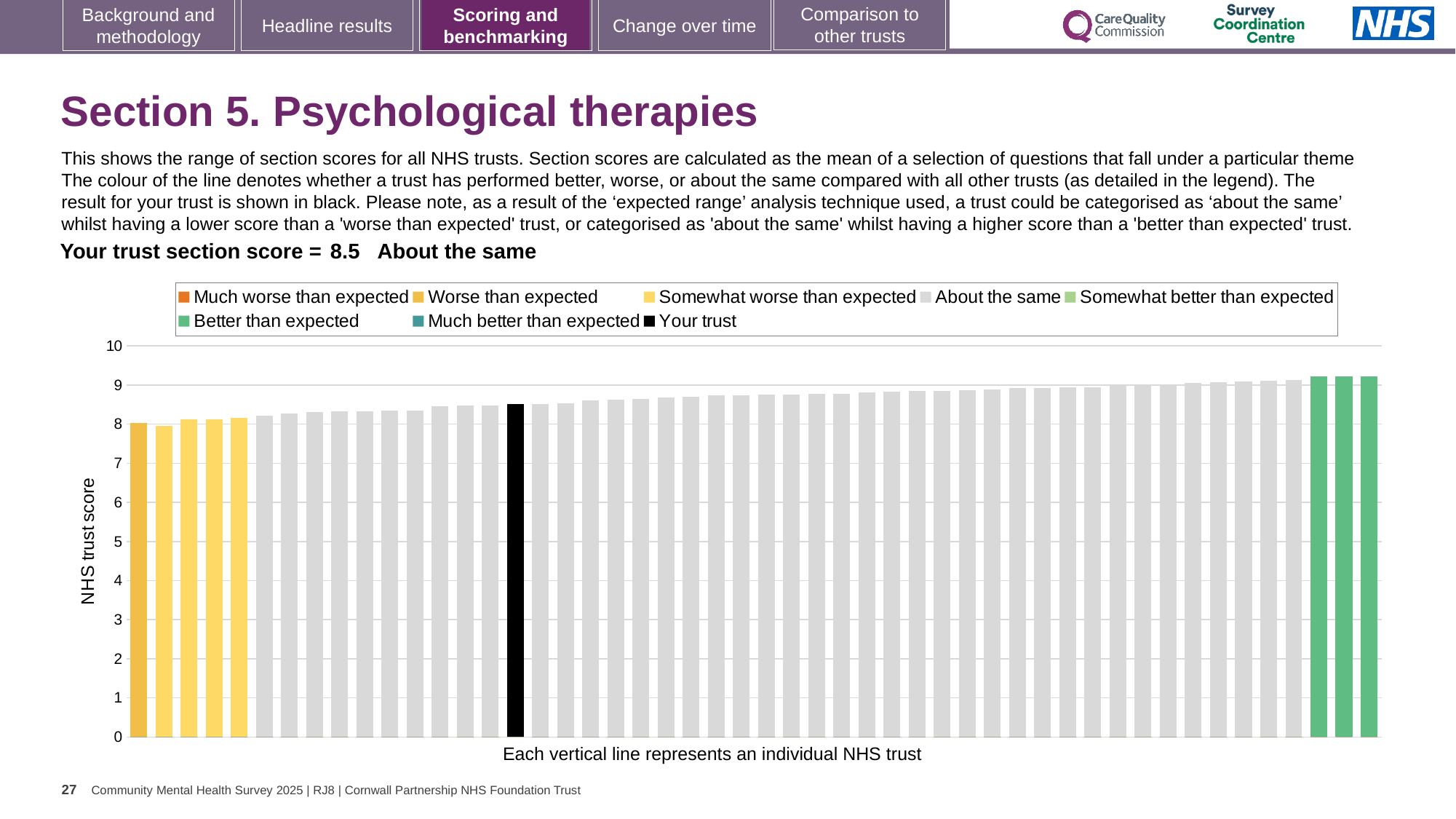
How many bars are shown in the 'Much worse than expected' colour? 0 Are the green bars at the right of the chart greater or less than 9? greater How many bars are coloured green (Better than expected)? 3 How many entries does the chart legend list? 8 What is the label on the vertical axis of the chart? NHS trust score What kind of chart is shown on the slide? bar chart Do the bar values rise or fall from left to right along the x axis? rise What is the section score for your trust shown on the slide? 8.5 How many bars are coloured in the 'Somewhat worse than expected' shade? 4 Which category is your trust placed in for this section? About the same Is the value for your trust (the black bar) greater or less than 8? greater Is the value for your trust (the black bar) greater or less than 9? less